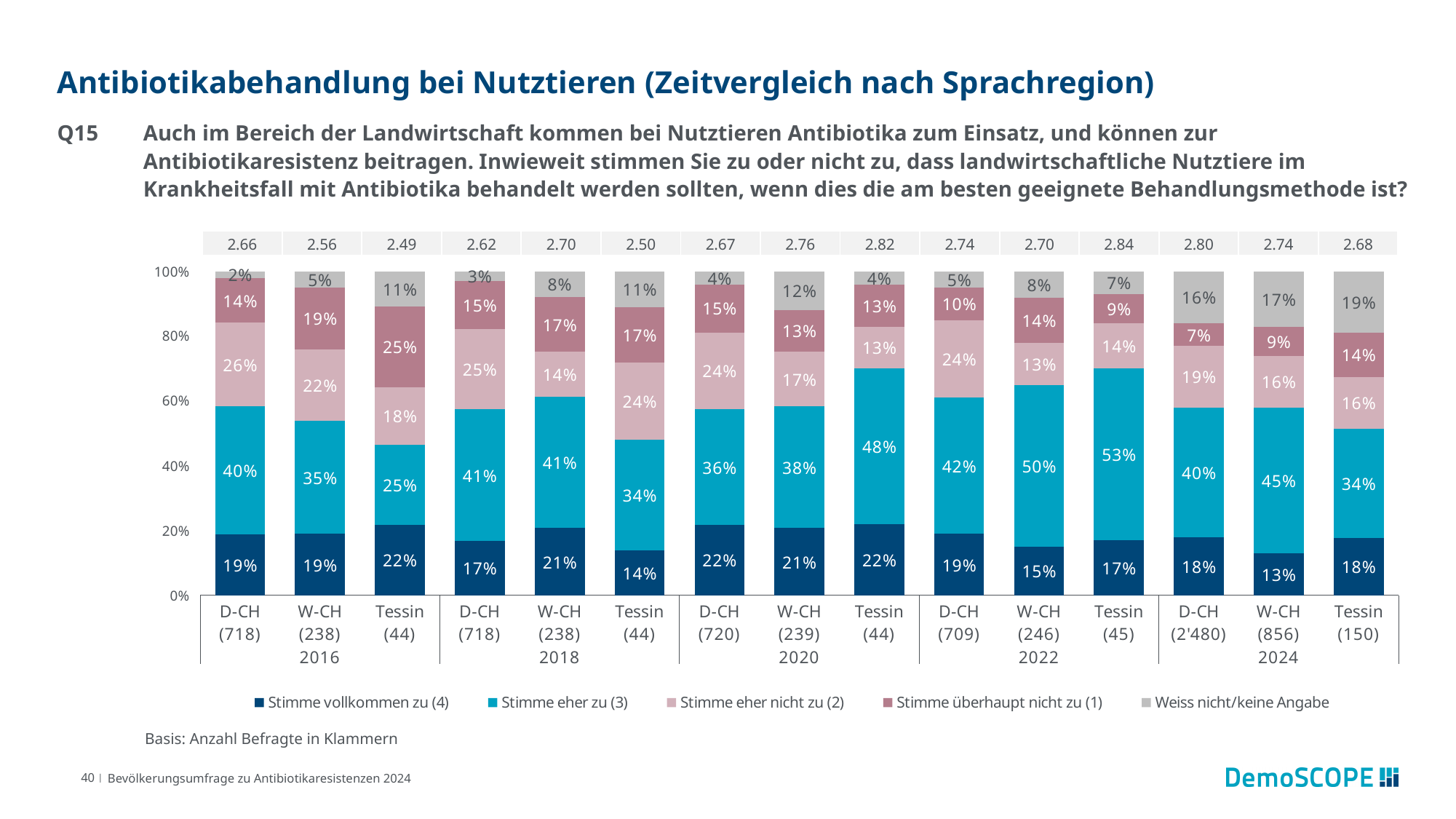
Which bar has the highest value for "Stimme eher zu (3)"? Tessin 2022 (53%) How does the "Weiss nicht/keine Angabe" share for D-CH change from 2016 to 2024? It rises (from 2% to 16%) Which bar has the lowest value for "Stimme vollkommen zu (4)"? W-CH 2024 (13%) What mean value is shown above the bar for Tessin in 2022? 2.84 How many series does the legend list? 5 Which is larger: the "Stimme überhaupt nicht zu (1)" value for Tessin in 2016 or for Tessin in 2024? Tessin 2016 (25%) How many stacked bars are shown in the chart? 15 What is the difference between the "Stimme eher zu (3)" values for W-CH in 2022 and W-CH in 2016? 15 percentage points What kind of chart is shown on the slide? Stacked bar chart What percentage of D-CH respondents in 2016 answered "Stimme eher zu (3)"? 40% What is the value for "Stimme vollkommen zu (4)" for Tessin in 2020? 22% What share of W-CH respondents in 2024 answered "Weiss nicht/keine Angabe"? 17%